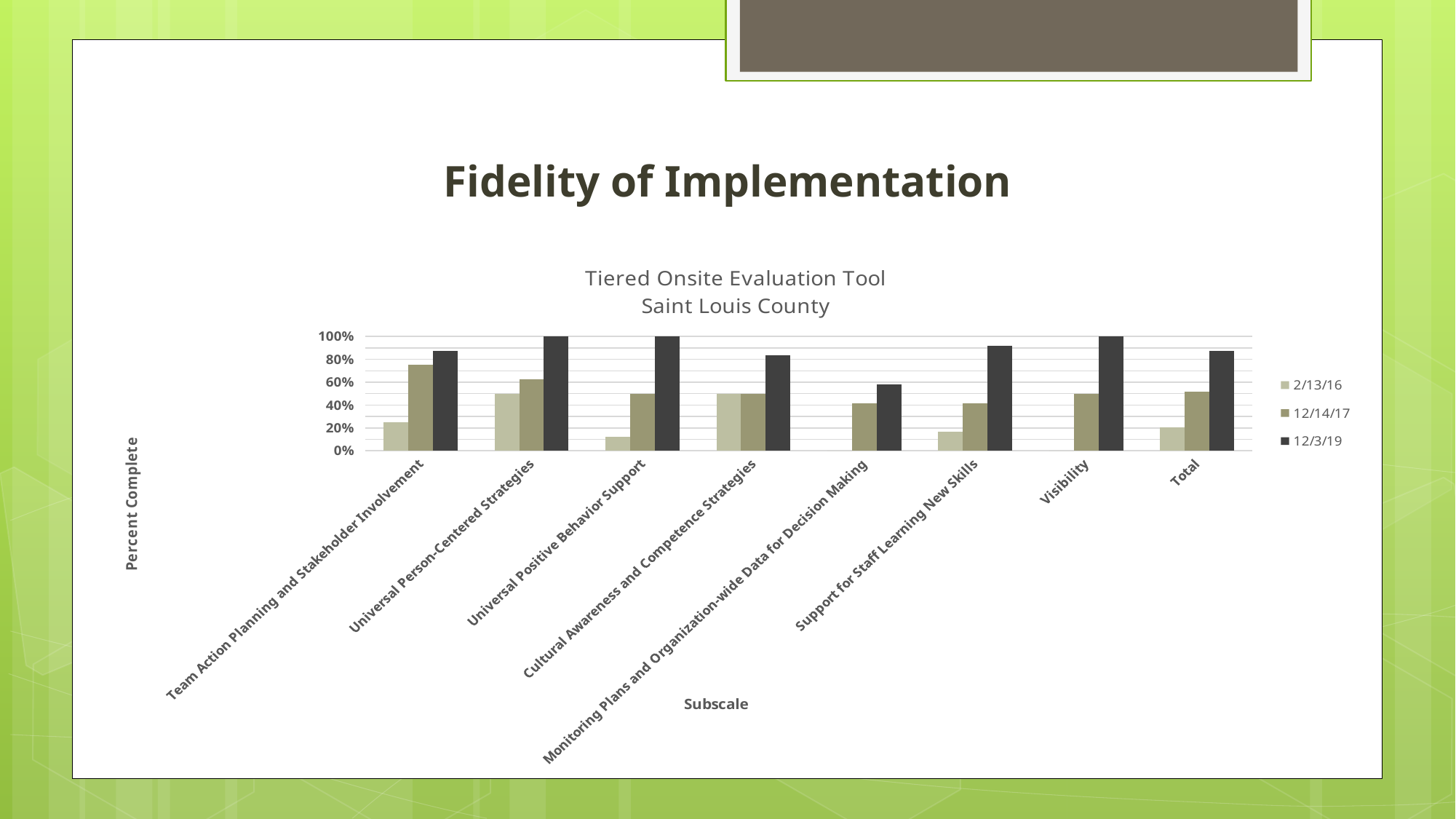
Which category has the lowest 12/3/19 value? Monitoring Plans and Organization-wide Data for Decision Making Is the 2/13/16 value for Team Action Planning and Stakeholder Involvement greater or less than 40%? less For Total, which is larger: the 12/14/17 value or the 12/3/19 value? 12/3/19 What kind of chart is shown on the slide? bar chart How many subscale categories are shown on the x axis? 8 Which series has the lowest value for Universal Positive Behavior Support? 2/13/16 How many series does the legend list? 3 For Team Action Planning and Stakeholder Involvement, do the values rise or fall from 2/13/16 to 12/3/19? rise Is the 12/3/19 value for Monitoring Plans and Organization-wide Data for Decision Making greater or less than 80%? less What is the 12/3/19 value for Visibility? 100% What is the label on the vertical axis of the chart? Percent Complete